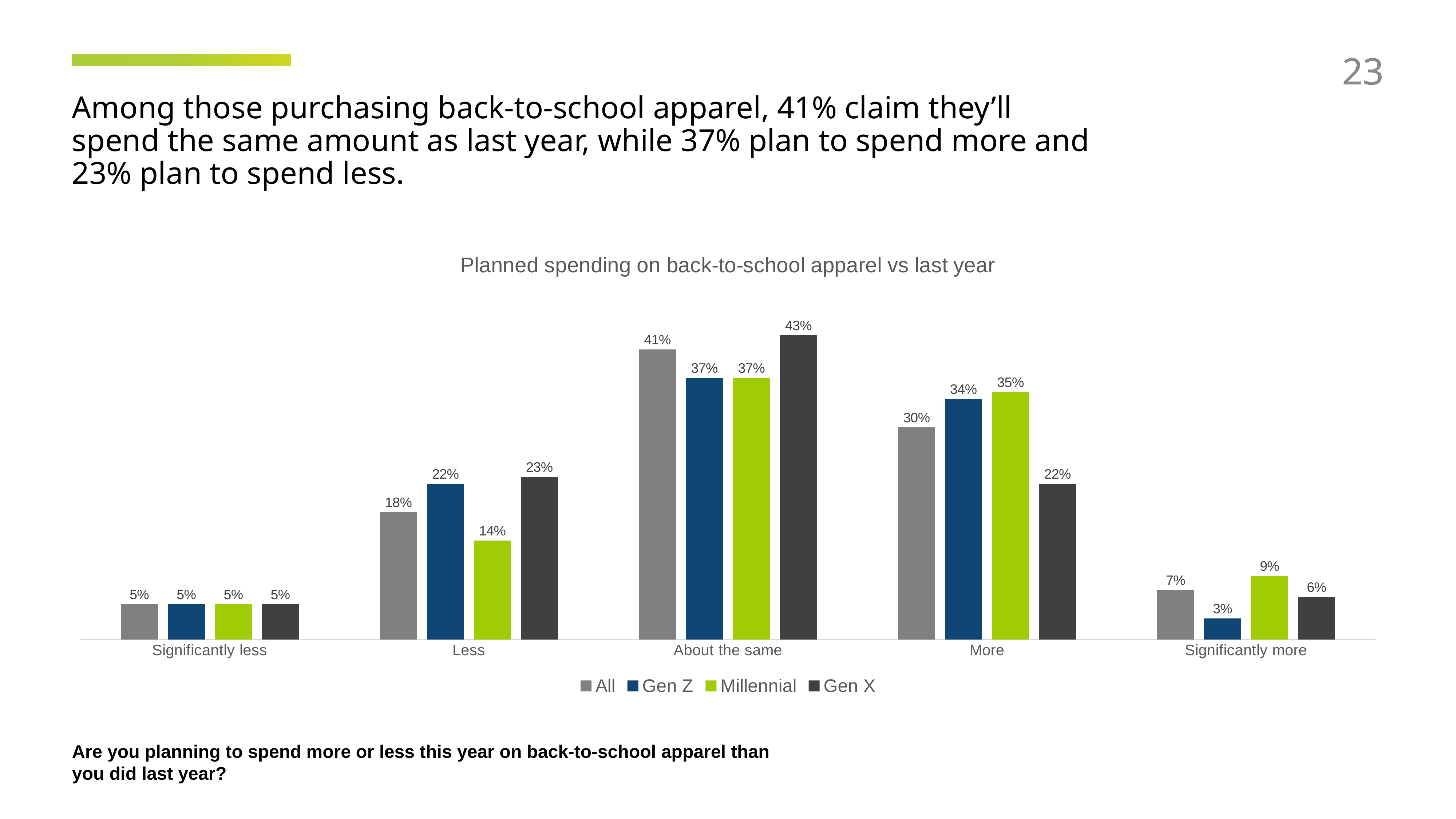
What is the value for Millennial in the 'Less' category? 14% How many categories are shown on the x axis? 5 Which category has the lowest value for the Gen Z series? Significantly more How many series does the legend list? 4 Which category has the highest value for the 'All' series? About the same Which series is shown in green in the legend? Millennial What is the difference between the Gen X and Millennial values in the 'More' category? 13% Which is larger in the 'Less' category: the Gen Z value or the Millennial value? Gen Z What kind of chart is shown on the slide? Bar chart What is the title of the chart? Planned spending on back-to-school apparel vs last year What is the value for Gen Z in the 'Significantly more' category? 3% What is the value for Gen X in the 'About the same' category? 43%